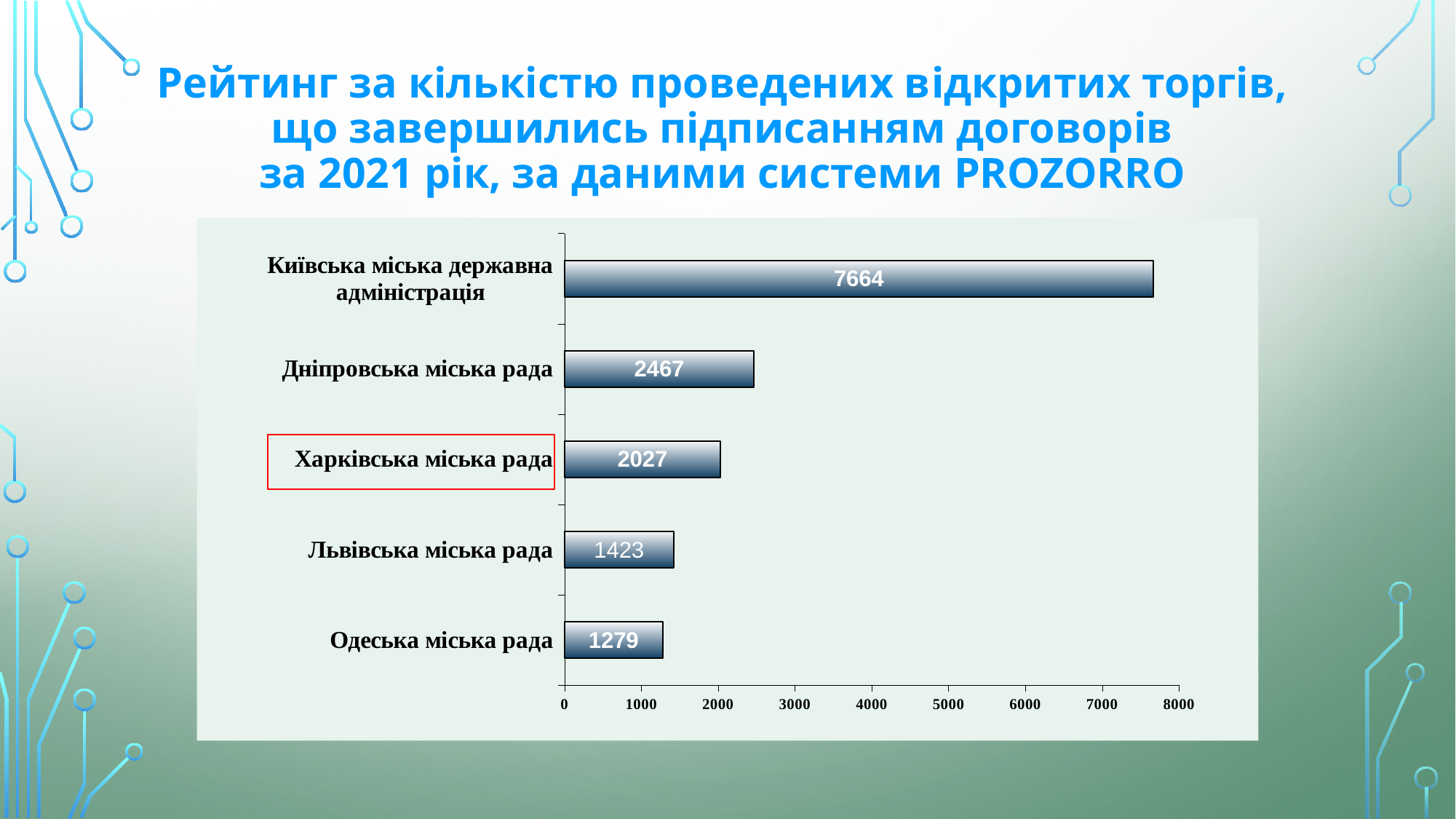
Which category has the highest value? Київська міська державна адміністрація Which category has the lowest value? Одеська міська рада Is the value for Харківська міська рада greater or less than 3000? less What kind of chart is shown on the slide? bar chart How many categories are shown in the chart? 5 Which category label is outlined with a red box? Харківська міська рада What is the value for Київська міська державна адміністрація? 7664 What is the difference between the values for Дніпровська міська рада and Харківська міська рада? 440 What is the value for Одеська міська рада? 1279 Which is larger, the value for Дніпровська міська рада or the value for Львівська міська рада? Дніпровська міська рада What is the difference between the values for Львівська міська рада and Одеська міська рада? 144 What is the value for Харківська міська рада? 2027